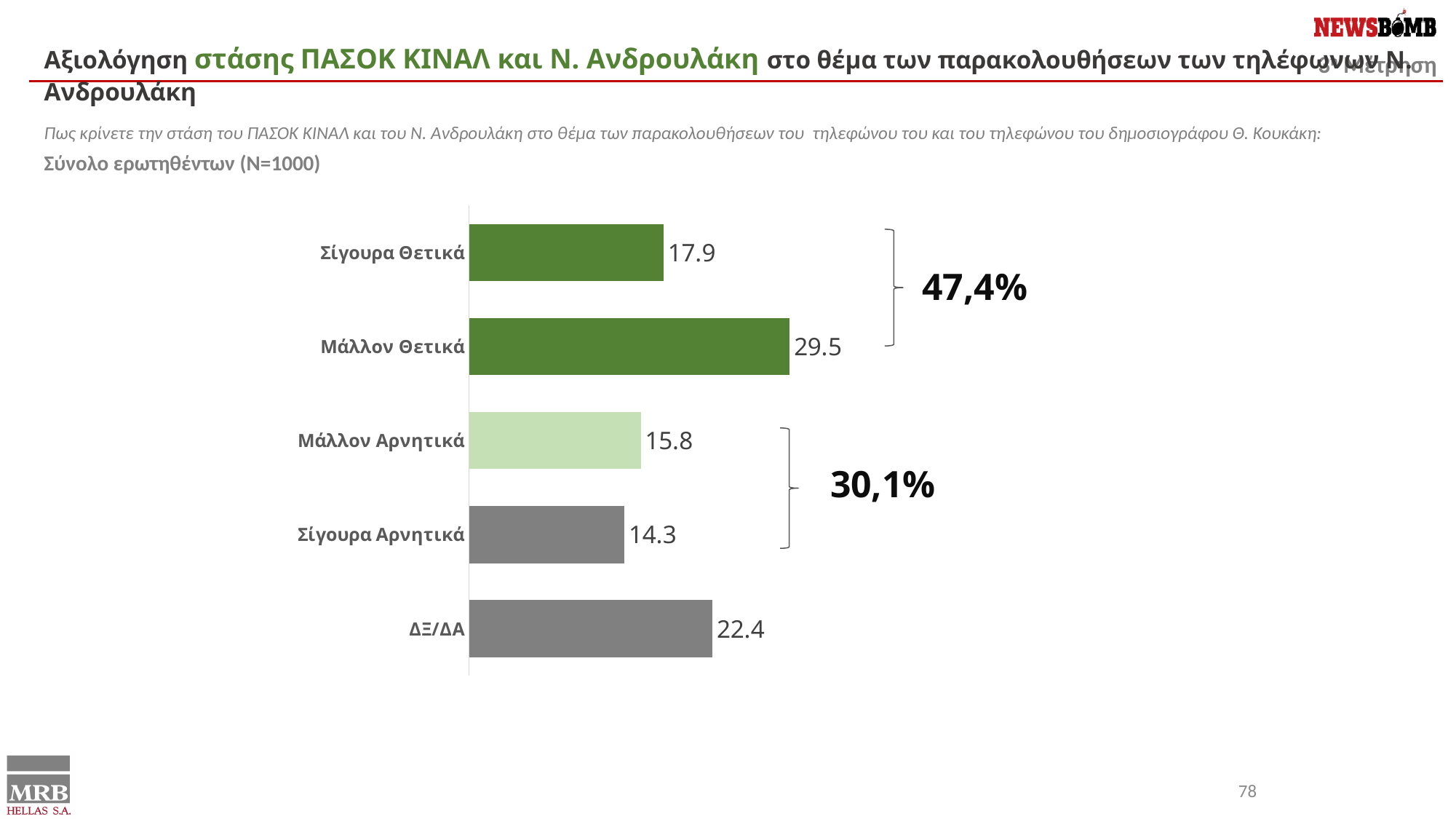
Which is larger, the value for ΔΞ/ΔΑ or the value for Σίγουρα Θετικά? ΔΞ/ΔΑ Which category has the highest value? Μάλλον Θετικά What is the value for ΔΞ/ΔΑ? 22.4 What is the difference between the values for Μάλλον Θετικά and Σίγουρα Θετικά? 11.6 What is the value for Μάλλον Θετικά? 29.5 What is the value for Σίγουρα Αρνητικά? 14.3 How many categories are shown in the chart? 5 Which category has the lowest value? Σίγουρα Αρνητικά What combined percentage is shown next to the bracket grouping Σίγουρα Θετικά and Μάλλον Θετικά? 47,4% What kind of chart is shown on the slide? Bar chart What is the value for Σίγουρα Θετικά? 17.9 What is the value for Μάλλον Αρνητικά? 15.8